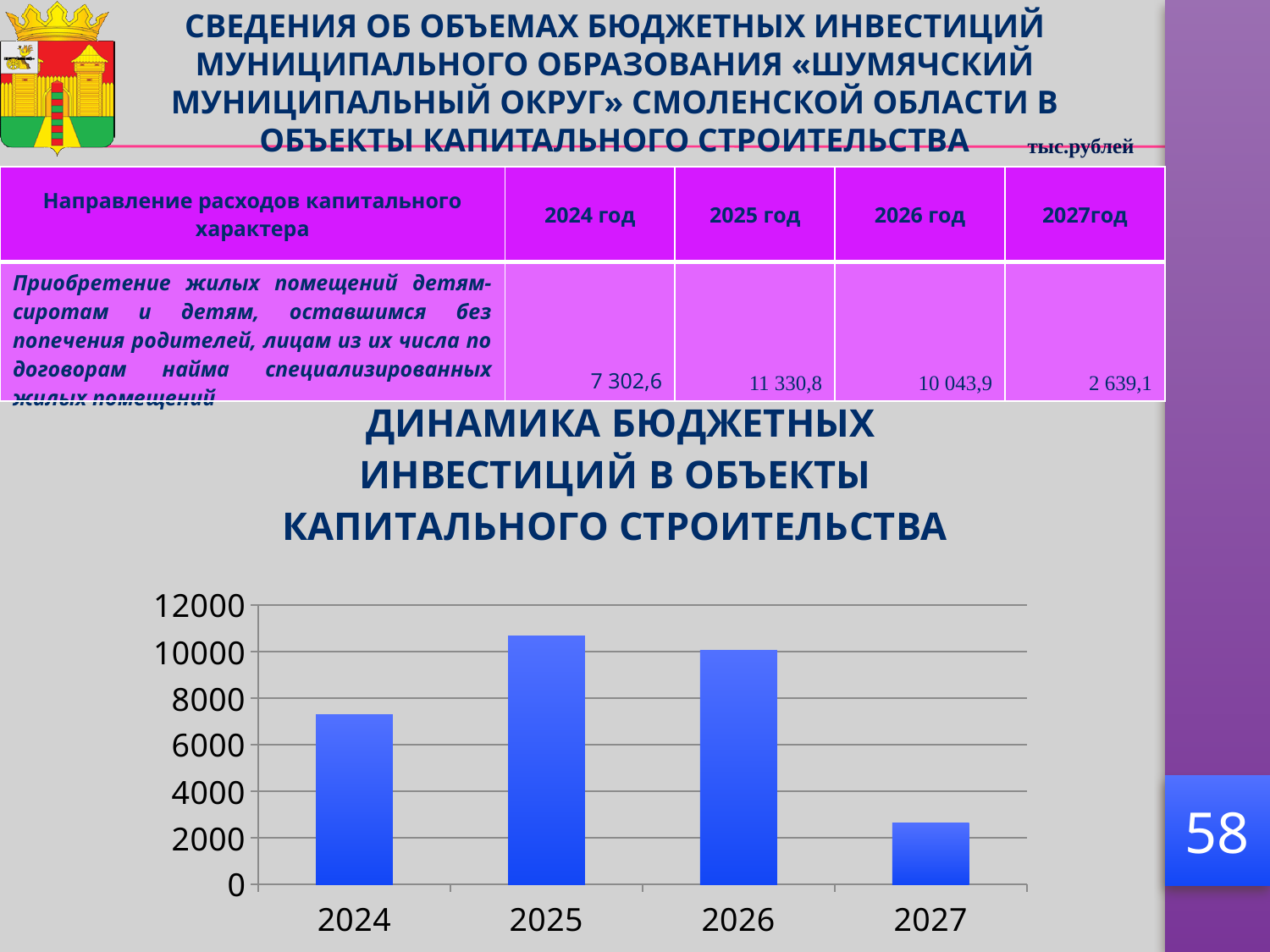
Is the value for 2024 greater or less than 6000? greater Which year has the highest bar in the chart? 2025 Which is larger, the value for 2025 or the value for 2024? 2025 How many years are shown on the x axis of the chart? 4 Is the value for 2027 greater or less than 4000? less Which year has the lowest bar in the chart? 2027 Is the value for 2025 greater or less than 10000? greater Which is larger, the value for 2024 or the value for 2027? 2024 What kind of chart is shown on the slide? bar chart Do the values rise or fall from 2025 to 2027? fall What is the highest tick value shown on the chart's vertical axis? 12000